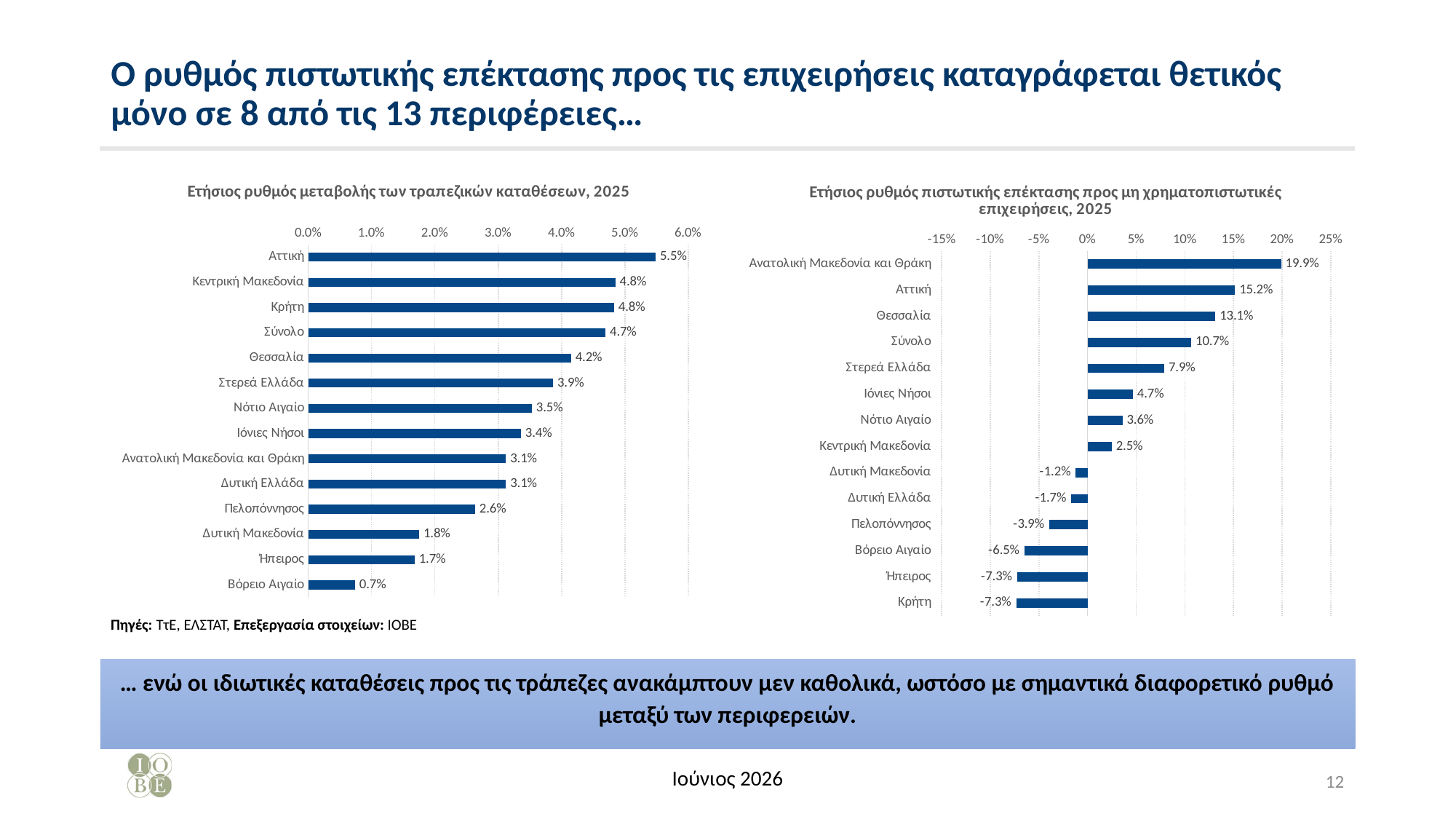
In the right chart (Ετήσιος ρυθμός πιστωτικής επέκτασης προς μη χρηματοπιστωτικές επιχειρήσεις, 2025), what is the value for Κρήτη? -7.3% In the left chart (Ετήσιος ρυθμός μεταβολής των τραπεζικών καταθέσεων, 2025), which category has the lowest value? Βόρειο Αιγαίο In the right chart (Ετήσιος ρυθμός πιστωτικής επέκτασης προς μη χρηματοπιστωτικές επιχειρήσεις, 2025), which category has the highest value? Ανατολική Μακεδονία και Θράκη In the right chart (Ετήσιος ρυθμός πιστωτικής επέκτασης προς μη χρηματοπιστωτικές επιχειρήσεις, 2025), what is the value for Ανατολική Μακεδονία και Θράκη? 19.9% In the left chart (Ετήσιος ρυθμός μεταβολής των τραπεζικών καταθέσεων, 2025), what is the value for Σύνολο? 4.7% In the left chart (Ετήσιος ρυθμός μεταβολής των τραπεζικών καταθέσεων, 2025), how many categories are shown? 14 In the right chart (Ετήσιος ρυθμός πιστωτικής επέκτασης προς μη χρηματοπιστωτικές επιχειρήσεις, 2025), how many categories have negative values? 6 In the left chart (Ετήσιος ρυθμός μεταβολής των τραπεζικών καταθέσεων, 2025), what is the value for Αττική? 5.5% What type of chart is the left chart (Ετήσιος ρυθμός μεταβολής των τραπεζικών καταθέσεων, 2025)? Bar chart In the left chart (Ετήσιος ρυθμός μεταβολής των τραπεζικών καταθέσεων, 2025), what is the difference between Αττική and Βόρειο Αιγαίο? 4.8% In the right chart (Ετήσιος ρυθμός πιστωτικής επέκτασης προς μη χρηματοπιστωτικές επιχειρήσεις, 2025), what is the difference between Αττική and Σύνολο? 4.5% In the right chart (Ετήσιος ρυθμός πιστωτικής επέκτασης προς μη χρηματοπιστωτικές επιχειρήσεις, 2025), which is larger: Θεσσαλία or Στερεά Ελλάδα? Θεσσαλία